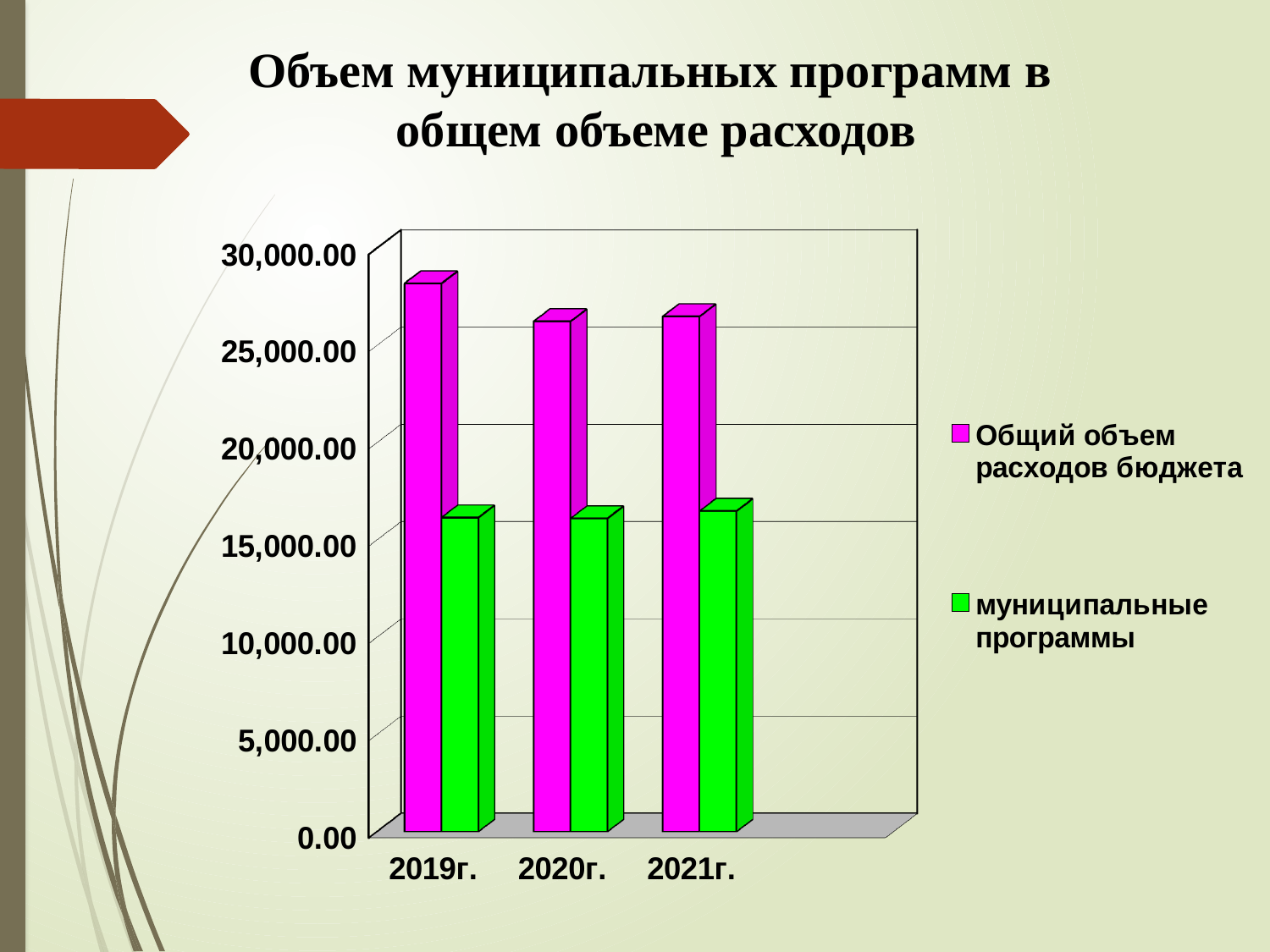
Is the value for муниципальные программы in 2021г. greater or less than 15,000.00? greater Is the value for муниципальные программы in 2019г. greater or less than 20,000.00? less What type of chart is shown on the slide? bar chart In 2021г., which series has the larger value: Общий объем расходов бюджета or муниципальные программы? Общий объем расходов бюджета How many years are shown on the x axis? 3 What colour are the bars for муниципальные программы? green Is the value for Общий объем расходов бюджета in 2019г. greater or less than 25,000.00? greater Which year has the highest value for Общий объем расходов бюджета? 2019г. What is the title of the slide? Объем муниципальных программ в общем объеме расходов Which is larger: Общий объем расходов бюджета in 2019г. or in 2020г.? 2019г. How many series does the legend list? 2